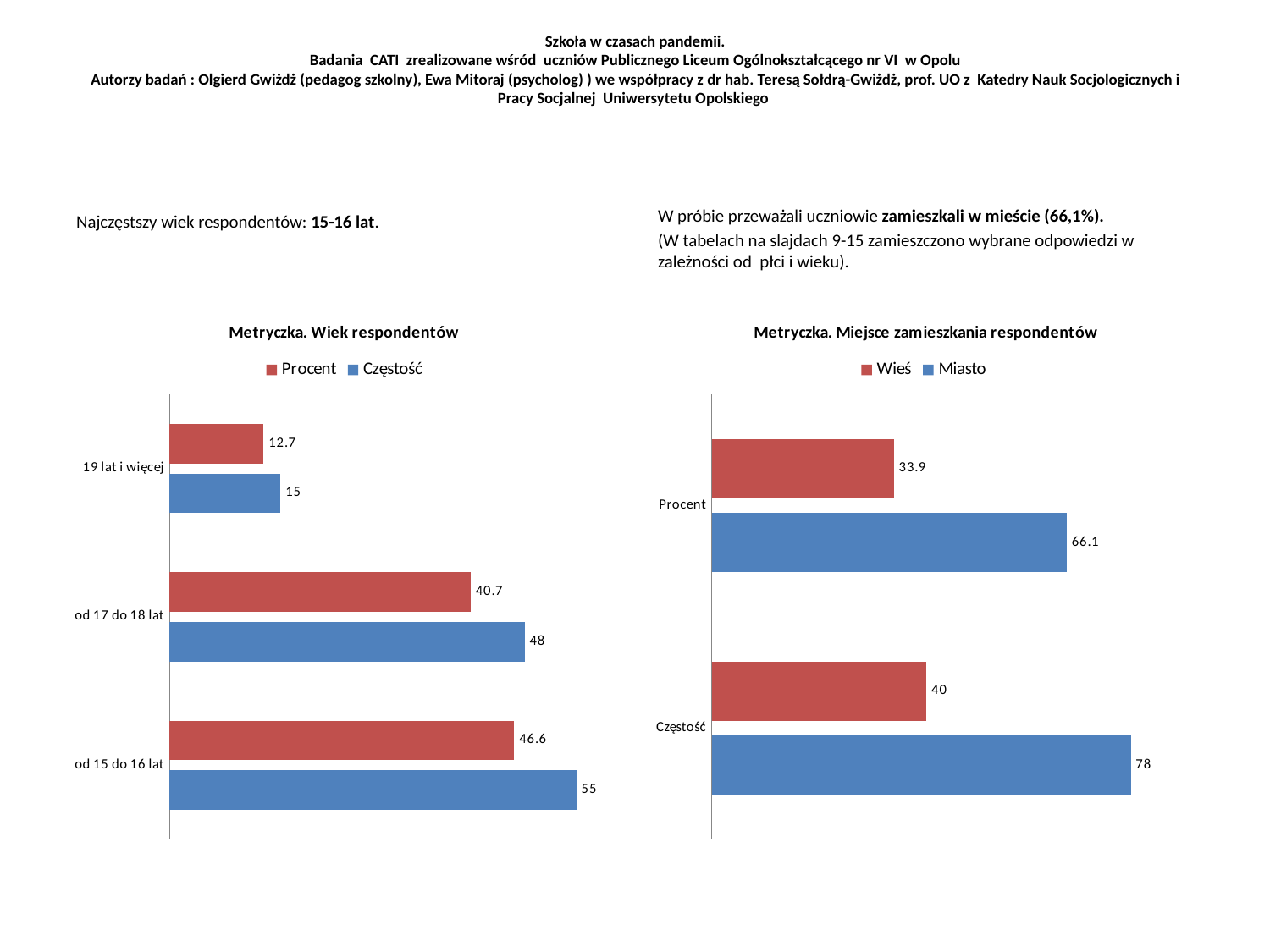
In the chart 'Metryczka. Miejsce zamieszkania respondentów', what is the difference between the Miasto and Wieś values for Częstość? 38 How many series does the legend of the chart 'Metryczka. Miejsce zamieszkania respondentów' list? 2 In the chart 'Metryczka. Wiek respondentów', what is the difference between the Częstość values for 'od 17 do 18 lat' and '19 lat i więcej'? 33 In the chart 'Metryczka. Wiek respondentów', which age category has the highest Częstość value? od 15 do 16 lat In the chart 'Metryczka. Wiek respondentów', which age category has the lowest Procent value? 19 lat i więcej What type of chart is 'Metryczka. Wiek respondentów'? Bar chart In the chart 'Metryczka. Miejsce zamieszkania respondentów', what is the Miasto value for Procent? 66.1 In the chart 'Metryczka. Wiek respondentów', what is the Procent value for '19 lat i więcej'? 12.7 In the chart 'Metryczka. Miejsce zamieszkania respondentów', what is the Wieś value for Częstość? 40 In the chart 'Metryczka. Wiek respondentów', how many age categories are shown? 3 In the chart 'Metryczka. Miejsce zamieszkania respondentów', which is larger for Procent: Wieś or Miasto? Miasto In the chart 'Metryczka. Wiek respondentów', what is the Częstość value for 'od 15 do 16 lat'? 55